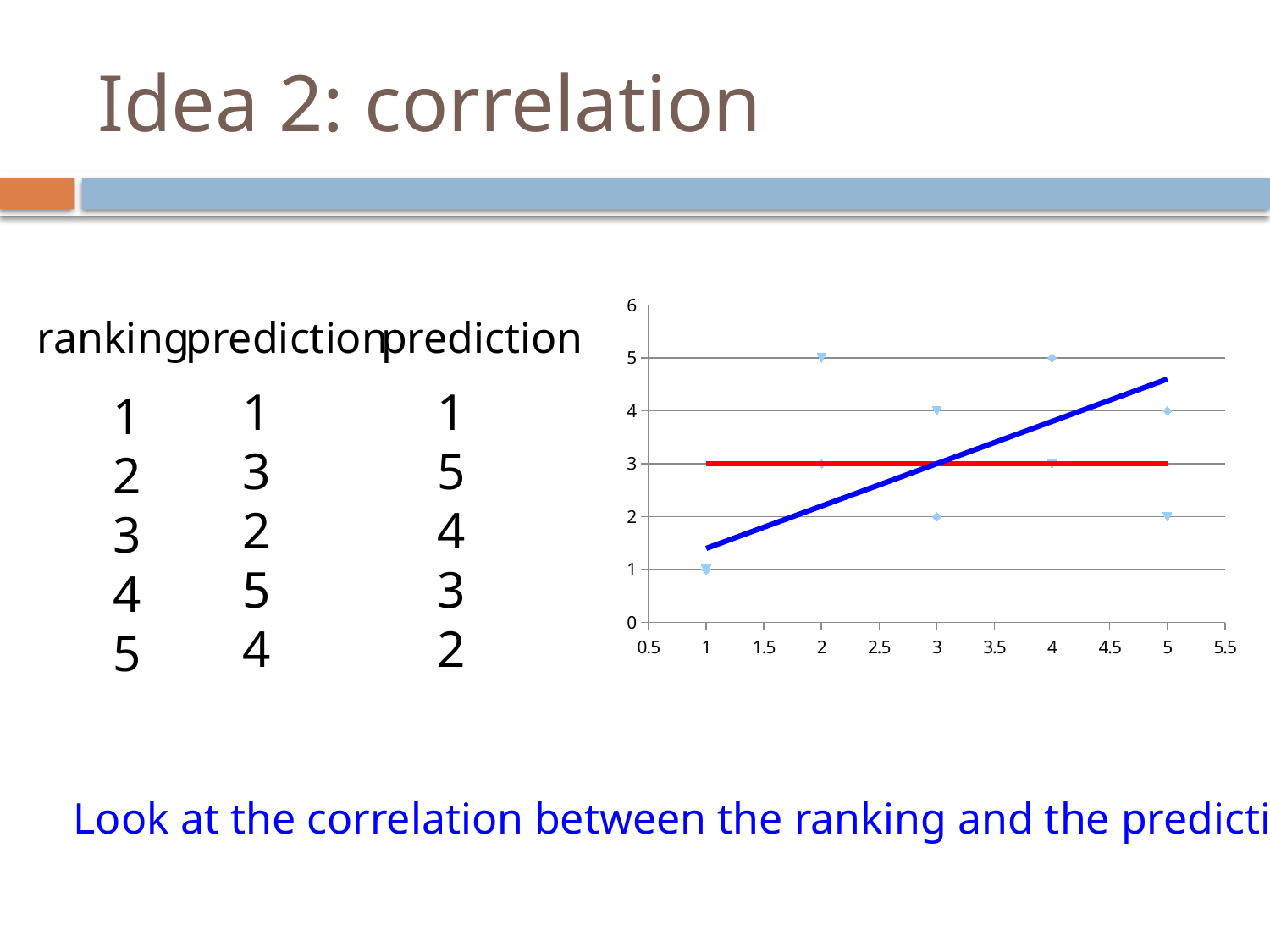
What is the difference between the highest and lowest y values of the plotted points? 4 What is the maximum value shown on the y axis? 6 Is the blue trend line at x = 1 greater or less than 2? less Is the blue trend line at x = 5 greater or less than 4? greater At how many distinct x positions are data points plotted? 5 What y value do the plotted points at x = 1 have? 1 Does the blue trend line rise or fall as x increases? rises At what y value does the red horizontal line sit? 3 What is the lowest y value reached by any plotted point? 1 What colour is the flat horizontal line on the chart? red What is the highest y value reached by any plotted point? 5 What kind of chart is shown on the slide? scatter chart